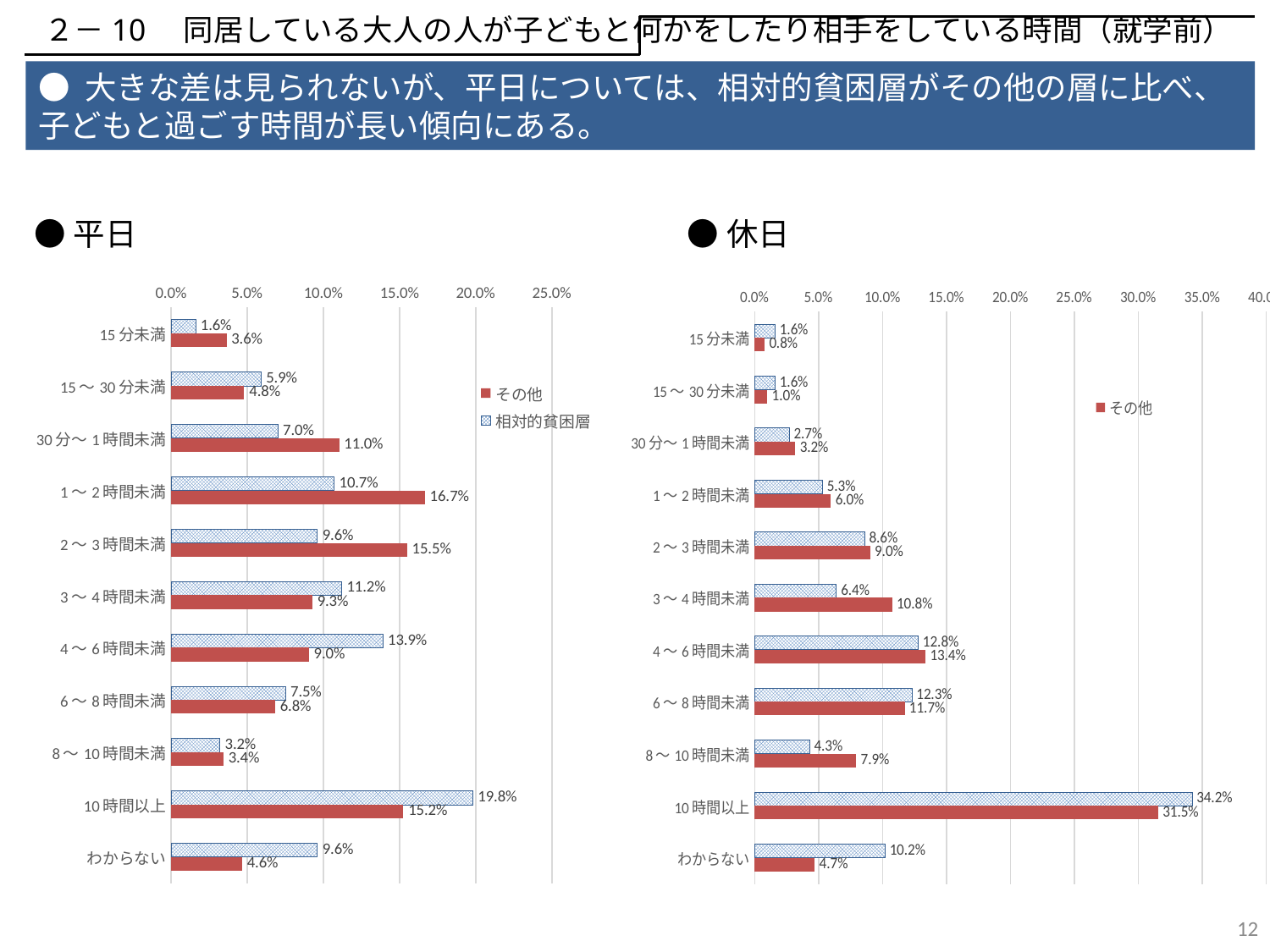
In the 休日 chart, which is larger for 3〜4時間未満: その他 or 相対的貧困層? その他 What type of chart is the 休日 chart? Bar chart How many series does the legend of the 平日 chart list? 2 In the 休日 chart, what is the value for その他 in the 10時間以上 category? 31.5% In the 平日 chart, what is the value for その他 in the 1〜2時間未満 category? 16.7% In the 休日 chart, what is the value for the blue hatched series (相対的貧困層) in the わからない category? 10.2% In the 平日 chart, which category has the highest value for その他? 1〜2時間未満 In the 平日 chart, what is the value for 相対的貧困層 in the 10時間以上 category? 19.8% How many categories are shown on the y axis of the 平日 chart? 11 In the 休日 chart, what is the difference between the 相対的貧困層 and その他 values for 10時間以上? 2.7% In the 平日 chart, what is the difference between the 相対的貧困層 and その他 values for 4〜6時間未満? 4.9% In the 休日 chart, which category has the lowest value for その他? 15分未満